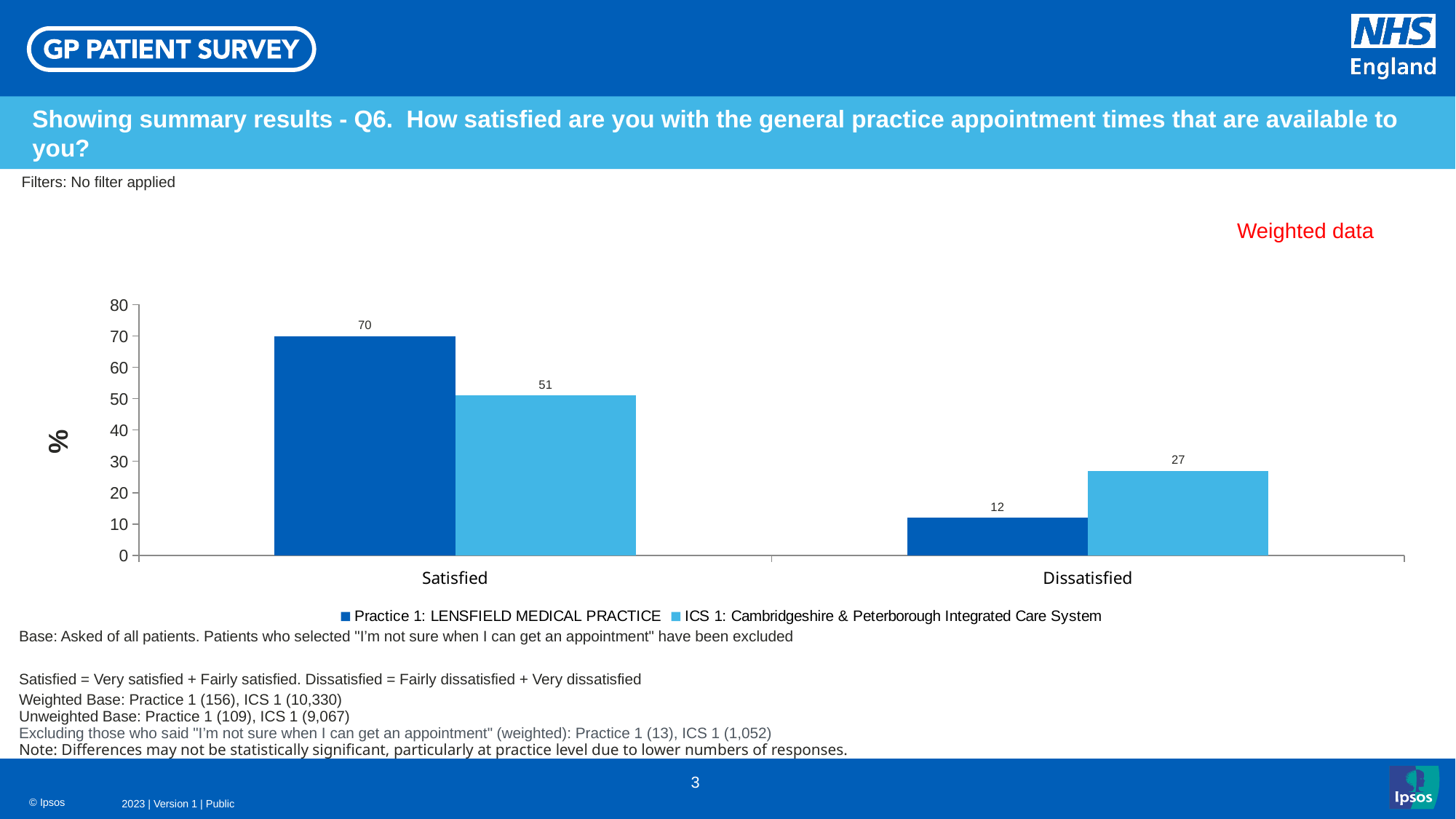
What is the difference between the Practice 1 and ICS 1 values in the Satisfied category? 19 Which category has the highest value for Practice 1: LENSFIELD MEDICAL PRACTICE? Satisfied How many categories are shown on the x axis? 2 What is the value for ICS 1: Cambridgeshire & Peterborough Integrated Care System in the Dissatisfied category? 27 What is the value for ICS 1: Cambridgeshire & Peterborough Integrated Care System in the Satisfied category? 51 In the Dissatisfied category, which series has the larger value: Practice 1 or ICS 1? ICS 1: Cambridgeshire & Peterborough Integrated Care System What is the value for Practice 1: LENSFIELD MEDICAL PRACTICE in the Dissatisfied category? 12 How many series does the legend list? 2 Which category has the lowest value for ICS 1: Cambridgeshire & Peterborough Integrated Care System? Dissatisfied What is the value for Practice 1: LENSFIELD MEDICAL PRACTICE in the Satisfied category? 70 What kind of chart is shown on the slide? Bar chart What is the difference between the ICS 1 and Practice 1 values in the Dissatisfied category? 15